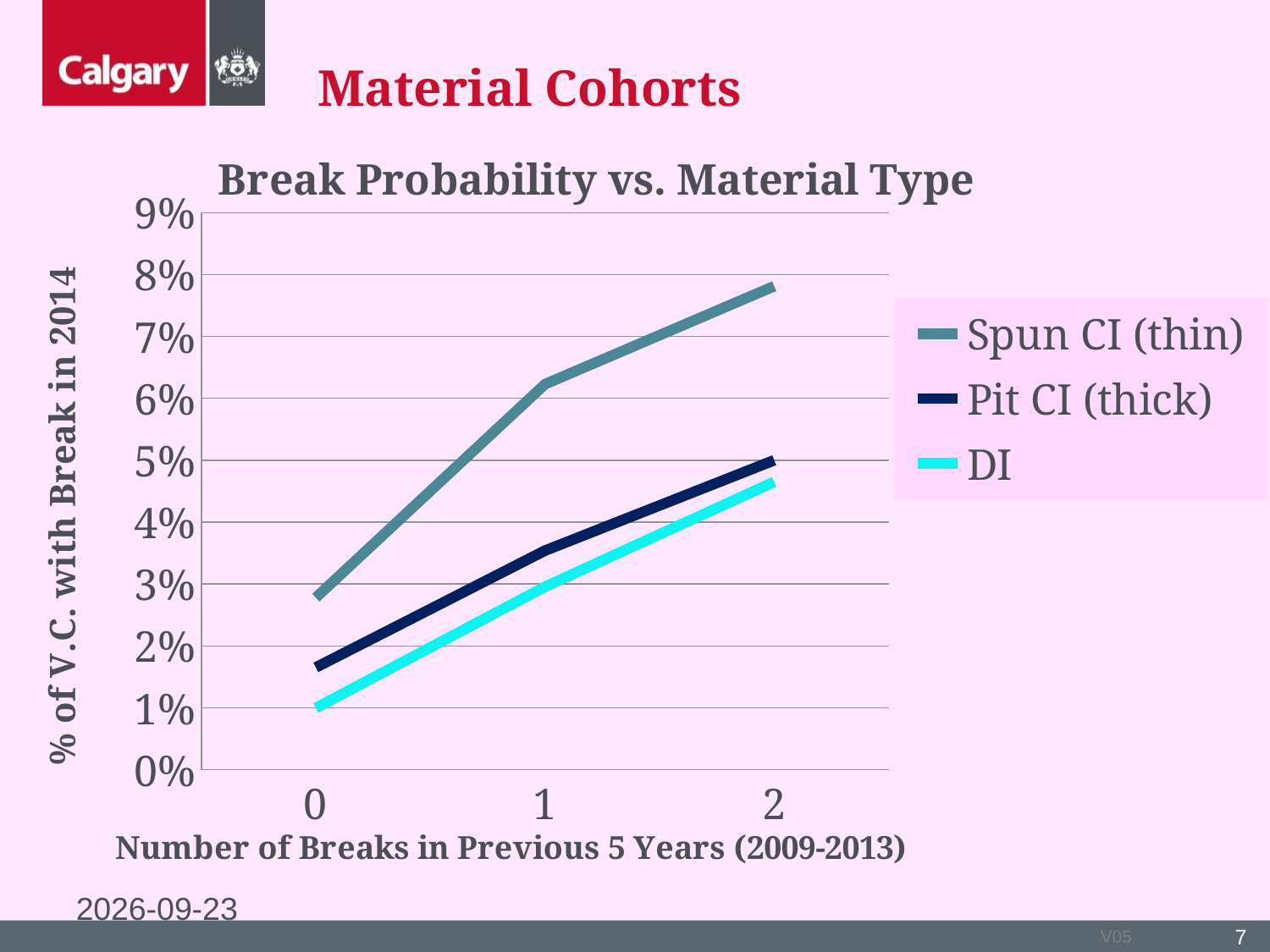
At 1 previous break, which is higher: Pit CI (thick) or DI? Pit CI (thick) What kind of chart is shown on the slide? line chart Which material type has the highest break probability at 2 previous breaks? Spun CI (thin) How many points along the x axis are plotted for each series? 3 How many series does the legend list? 3 Is the value for Pit CI (thick) at 1 previous break greater or less than 3%? greater Is the value for DI at 2 previous breaks greater or less than 5%? less Which material type has the lowest break probability at 0 previous breaks? DI Is the value for Spun CI (thin) at 2 previous breaks greater or less than 7%? greater Do the break probabilities rise or fall as the number of previous breaks increases? rise What is the title of the chart? Break Probability vs. Material Type